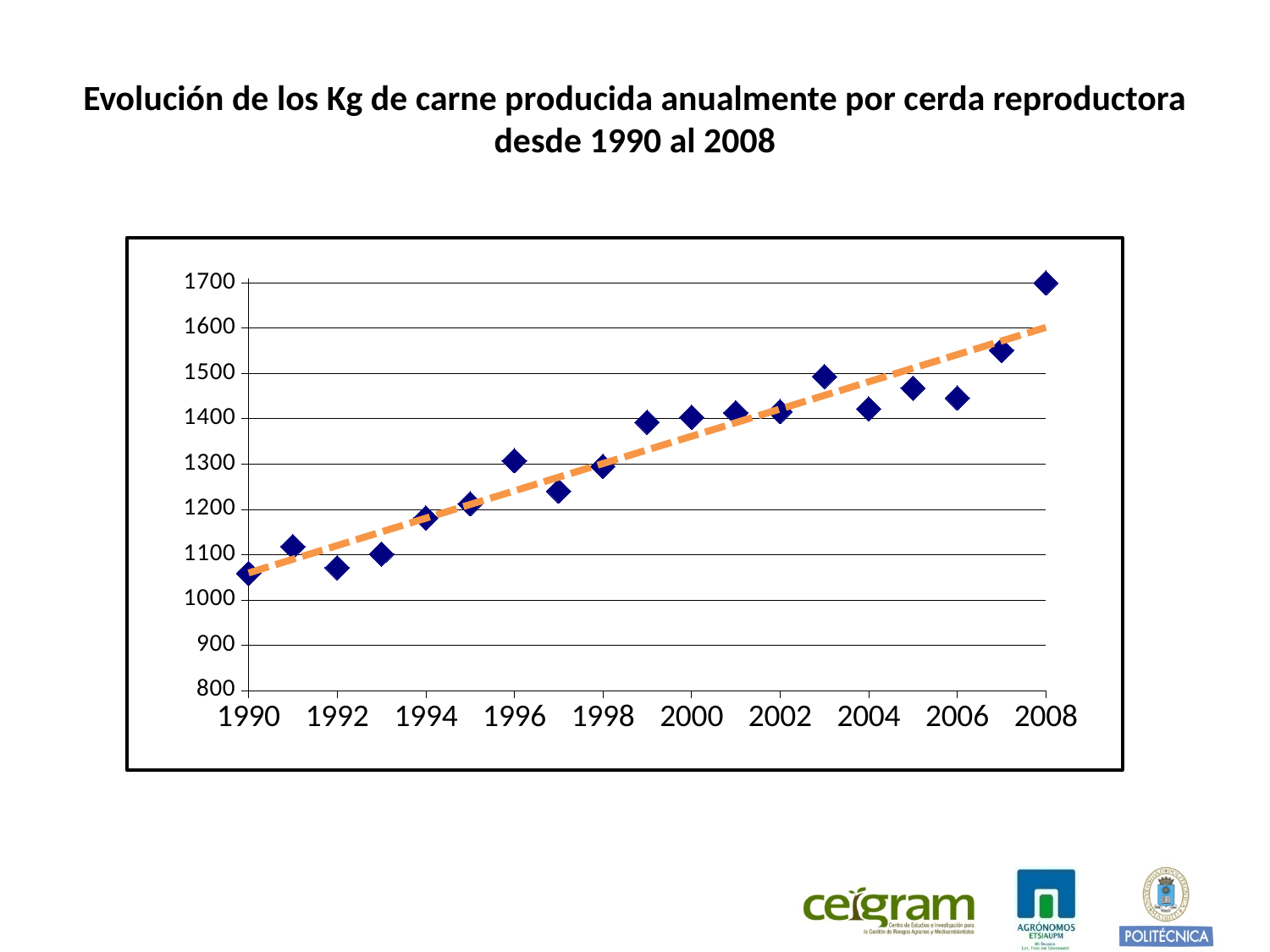
How many data points are plotted in the chart? 19 Do the values generally rise or fall from 1990 to 2008? rise What kind of chart is shown on the slide? scatter chart Is the value for 2003 greater or less than 1400? greater Is the value for 1994 greater or less than 1200? less Is the value for 1997 greater or less than 1300? less Which is larger, the value for 1996 or the value for 1997? 1996 Which is larger, the value for 2003 or the value for 2004? 2003 What is the title of the chart? Evolución de los Kg de carne producida anualmente por cerda reproductora desde 1990 al 2008 Which year has the highest value? 2008